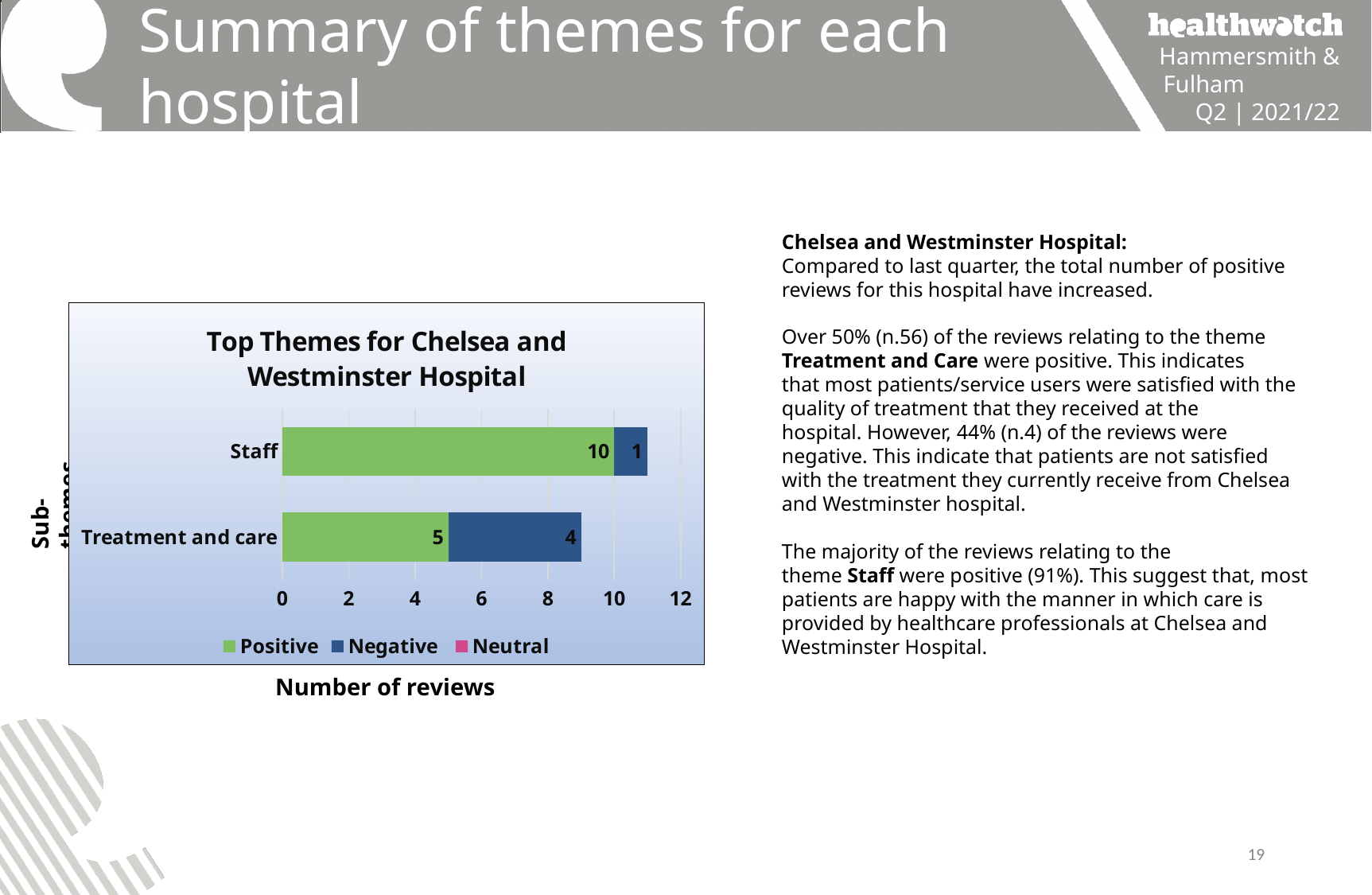
How many series does the legend list? 3 Which category has the higher Positive value, Staff or Treatment and care? Staff What is the difference between the Positive values for Staff and Treatment and care? 5 Which category has the lowest Negative value? Staff What is the Positive value for Staff? 10 How many categories are shown on the y axis? 2 What is the Negative value for Staff? 1 What is the total number of reviews for the Staff bar? 11 What is the Negative value for Treatment and care? 4 What type of chart is shown? Stacked bar chart What is the total number of reviews for the Treatment and care bar? 9 What is the Positive value for Treatment and care? 5